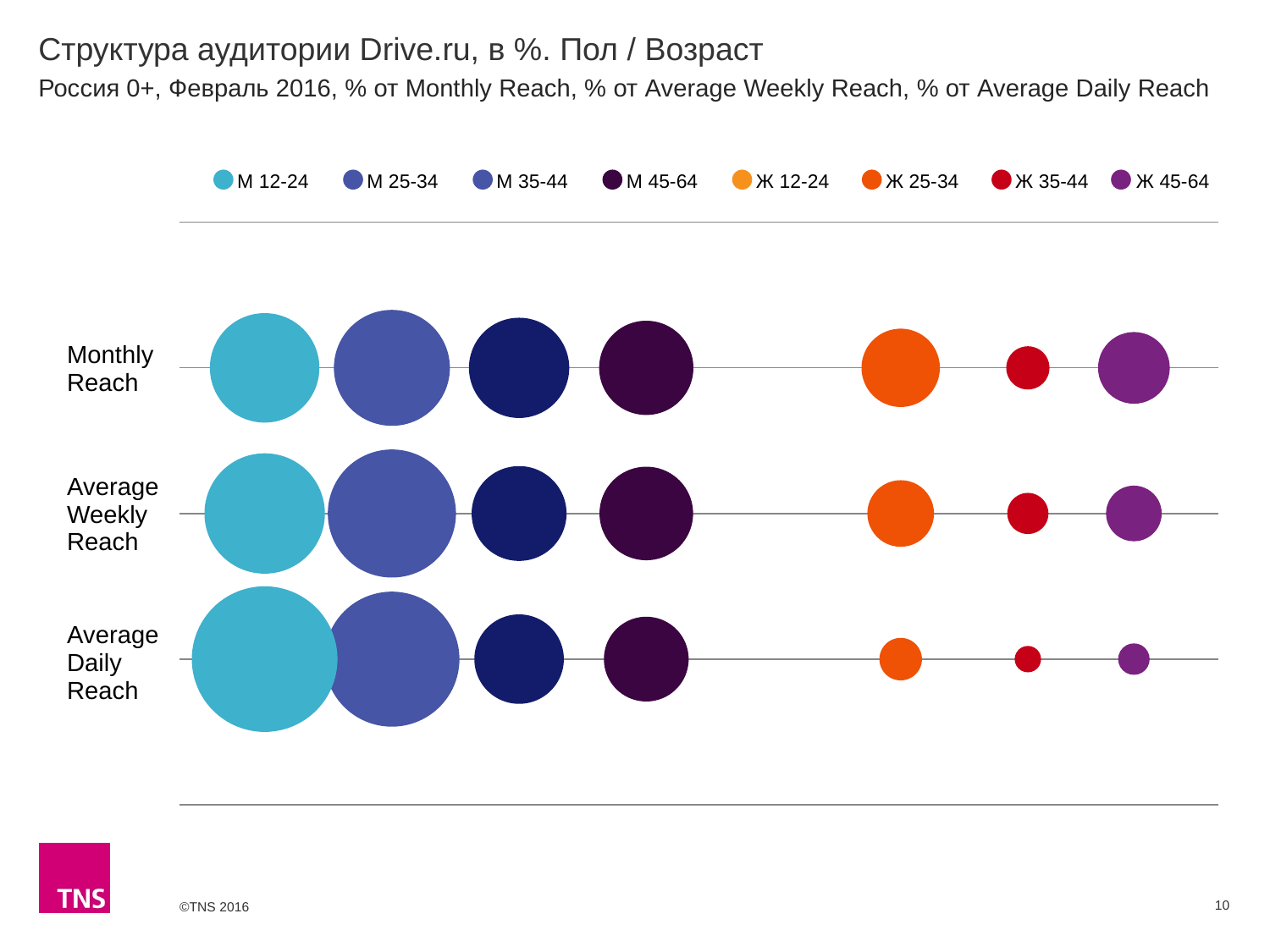
Which series has the smallest bubble in the Monthly Reach row? Ж 35-44 In the Average Daily Reach row, which bubble is larger: M 35-44 or Ж 25-34? M 35-44 What kind of chart is shown on the slide? Bubble chart Does the M 12-24 bubble grow or shrink going from Monthly Reach to Average Daily Reach? Grows How many reach categories (rows) are plotted on the chart? 3 Does the Ж 45-64 bubble grow or shrink going from Monthly Reach to Average Daily Reach? Shrinks Which legend series has no visible bubble in any row of the chart? Ж 12-24 What is the title of the chart on the slide? Структура аудитории Drive.ru, в %. Пол / Возраст In the Monthly Reach row, which bubble is larger: Ж 25-34 or Ж 45-64? Ж 25-34 In the Monthly Reach row, which bubble is larger: M 12-24 or Ж 35-44? M 12-24 How many series does the legend list? 8